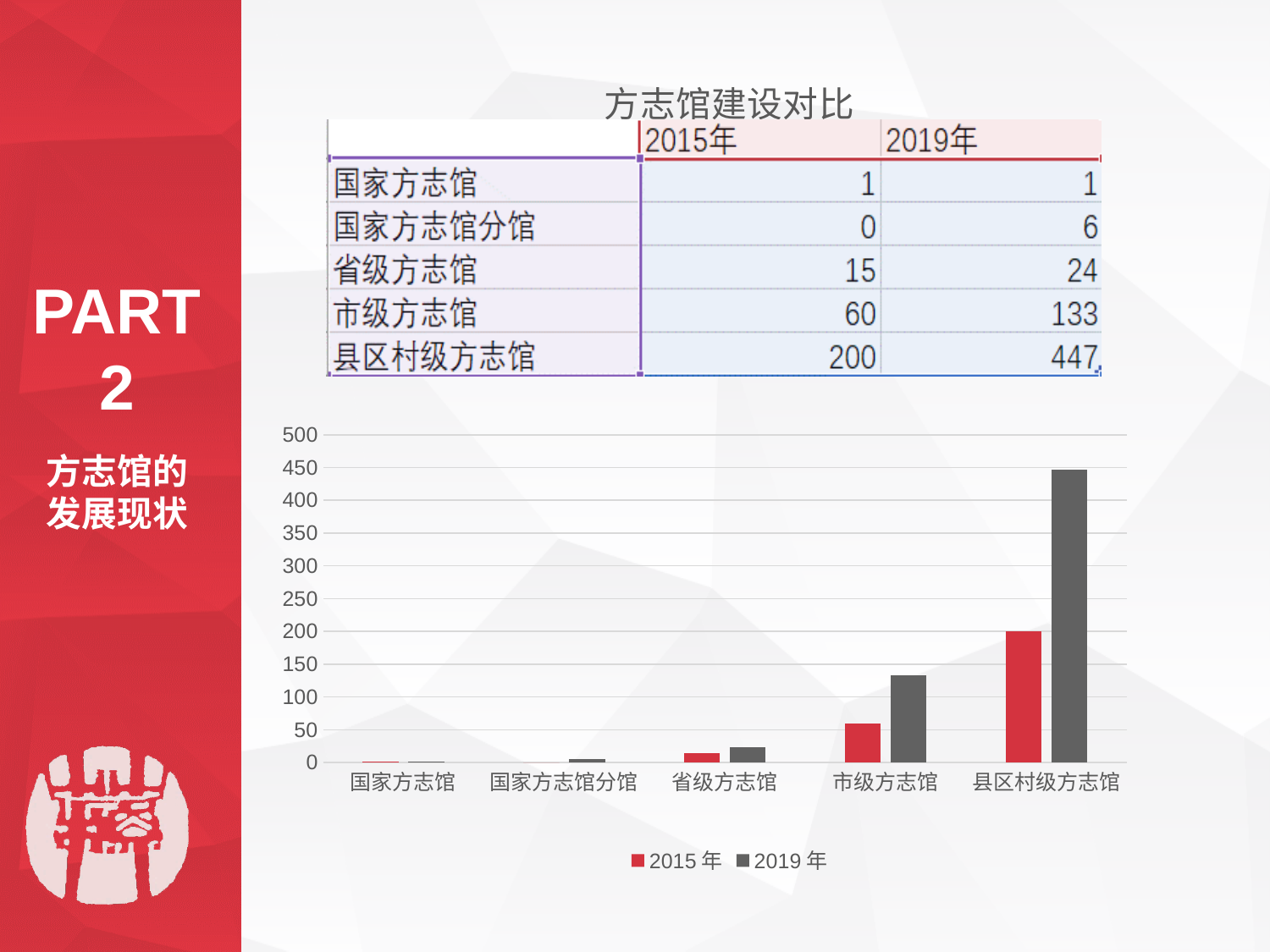
Which category has the lowest value in the 2015年 series? 国家方志馆分馆 How many series does the chart legend list? 2 Which category has the highest value in the 2019年 series? 县区村级方志馆 How many categories are shown on the x axis of the chart? 5 What is the title of the chart? 方志馆建设对比 What is the value for 市级方志馆 in 2015年? 60 What is the difference between the 2019年 and 2015年 values for 市级方志馆? 73 What is the value for 县区村级方志馆 in 2019年? 447 What is the value for 国家方志馆分馆 in 2019年? 6 Is the 2019年 value for 县区村级方志馆 greater or less than 400? greater Which is larger for 省级方志馆: the 2015年 value or the 2019年 value? 2019年 What kind of chart is shown on the slide? bar chart